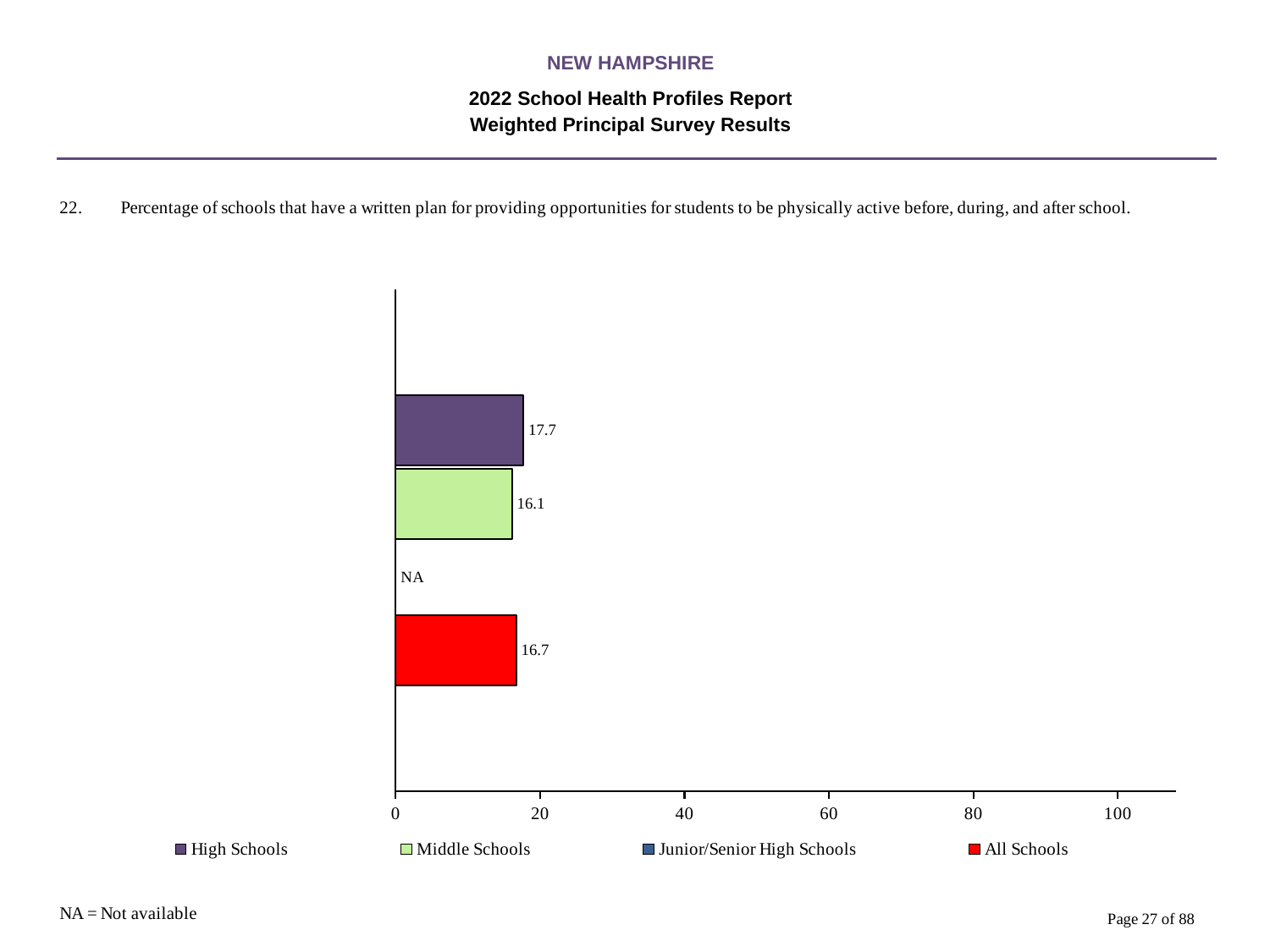
What is the value for All Schools? 16.7 What kind of chart is shown on the slide? Bar chart Which school category has the highest value? High Schools How many series does the legend list? 4 What is shown for Junior/Senior High Schools? NA Which is larger, the value for High Schools or the value for All Schools? High Schools Which school category with a plotted value has the lowest value? Middle Schools What is the difference between the High Schools value and the Middle Schools value? 1.6 What is the value for High Schools? 17.7 What is the value for Middle Schools? 16.1 What is the difference between the All Schools value and the Middle Schools value? 0.6 Is the value for High Schools greater or less than 20? less